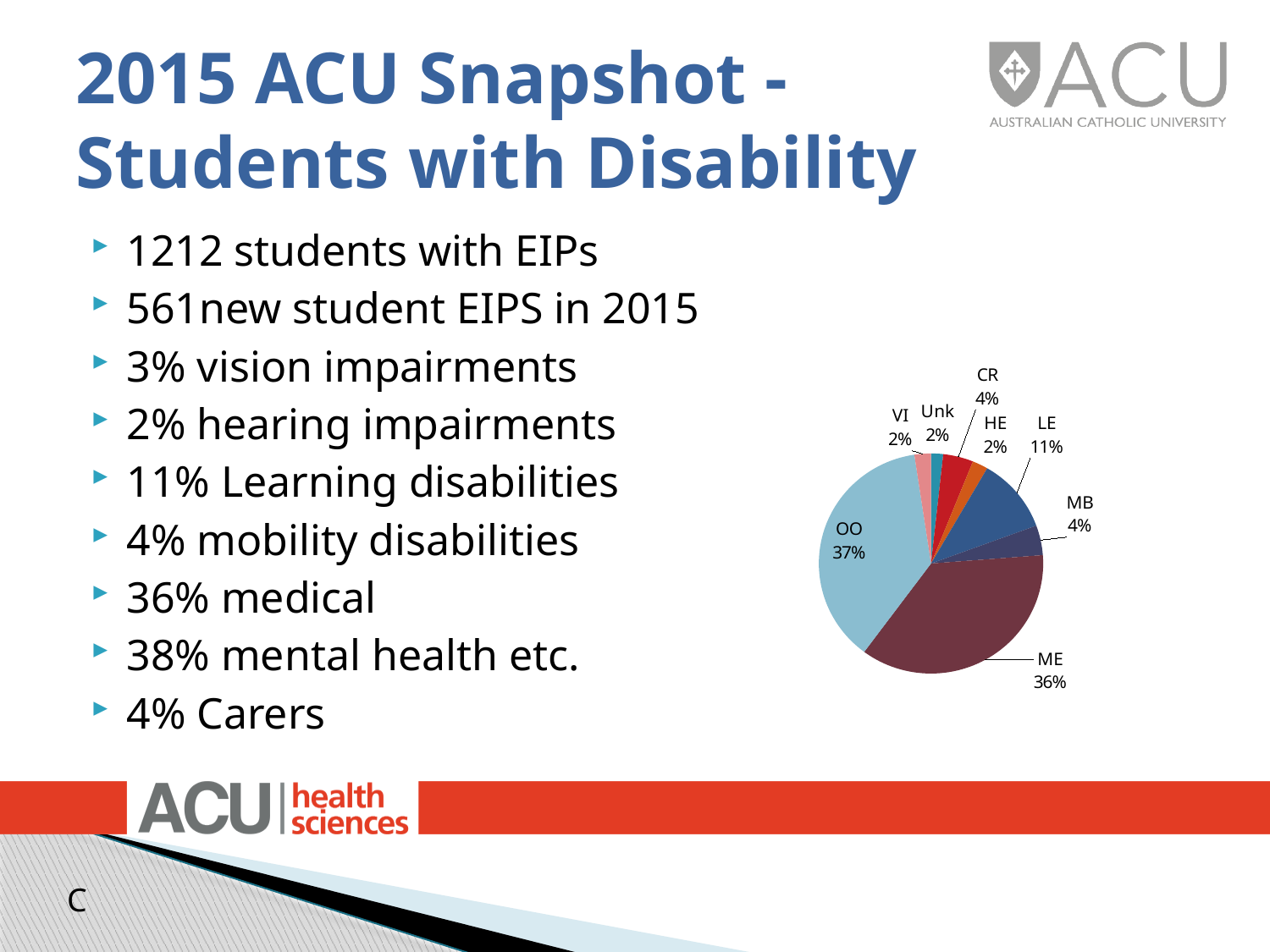
How many slices does the pie chart have? 8 What percentage is shown for the LE slice in the pie chart? 11% What type of chart is shown on the slide? Pie chart What is the difference in percentage points between the OO slice and the ME slice? 1% What percentage is shown for the Unk slice in the pie chart? 2% What percentage is shown for the CR slice in the pie chart? 4% What share of the pie chart does the OO slice represent? 37% What share of the pie chart does the ME slice represent? 36% Which slice of the pie chart is the largest? OO Which is larger in the pie chart, the LE slice or the CR slice? LE What percentage is shown for the MB slice in the pie chart? 4% What is the difference in percentage points between the LE slice and the MB slice? 7%